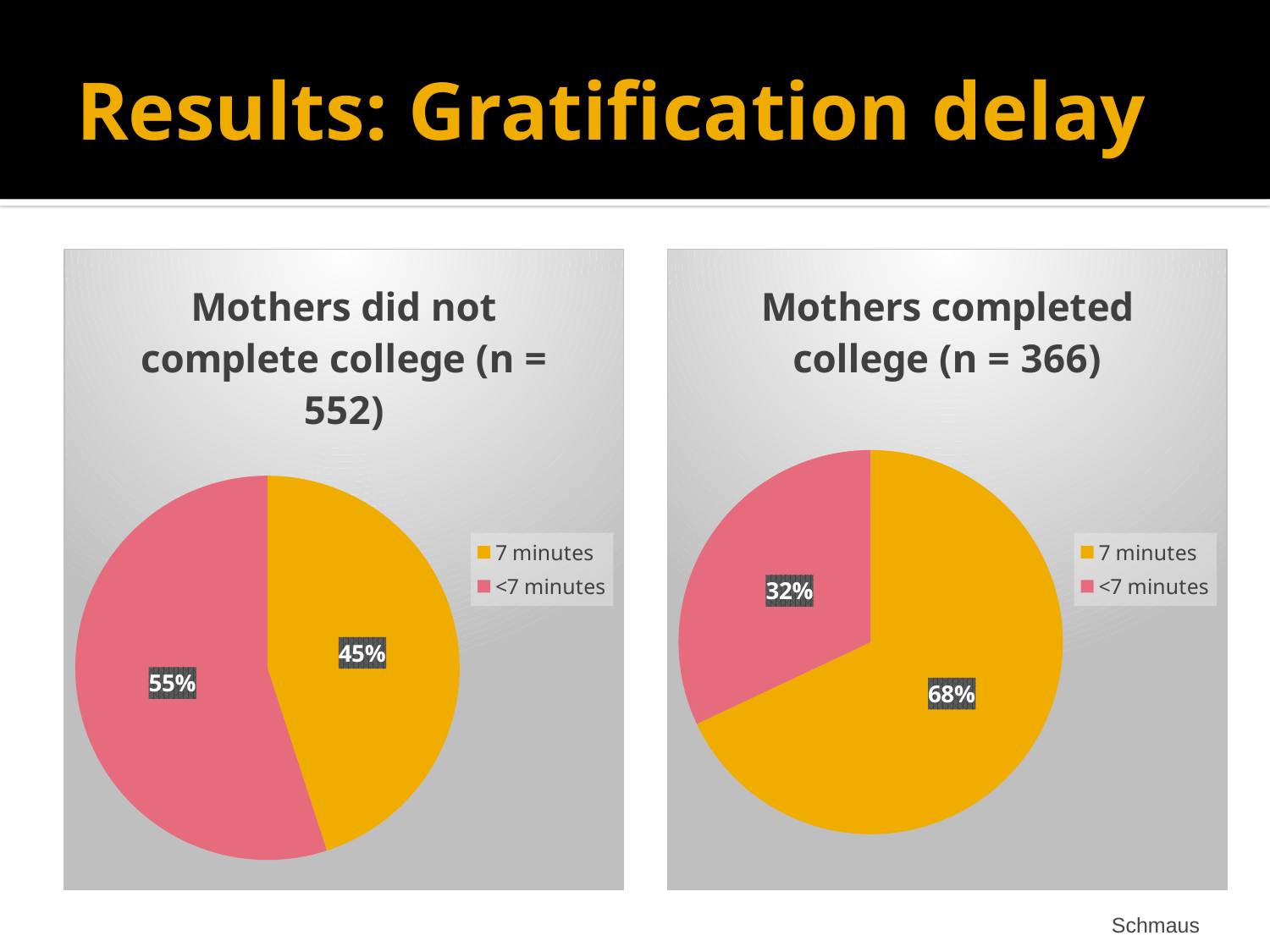
In the 'Mothers did not complete college (n = 552)' chart, what share of the pie is '7 minutes'? 45% In the 'Mothers completed college (n = 366)' chart, what is the difference between the '7 minutes' and '<7 minutes' shares? 36% In the 'Mothers did not complete college (n = 552)' chart, which slice is the largest? <7 minutes How many entries does the legend of the 'Mothers did not complete college (n = 552)' chart list? 2 In the 'Mothers completed college (n = 366)' chart, what share of the pie is '<7 minutes'? 32% Which chart has the larger '7 minutes' share, the left chart or the right chart? The right chart (Mothers completed college) In the 'Mothers completed college (n = 366)' chart, what share of the pie is '7 minutes'? 68% In the 'Mothers did not complete college (n = 552)' chart, what is the difference between the '<7 minutes' and '7 minutes' shares? 10% How many slices does the 'Mothers completed college (n = 366)' pie chart have? 2 In the 'Mothers completed college (n = 366)' chart, which slice is the smallest? <7 minutes What type of chart is used on the left of the slide? Pie chart